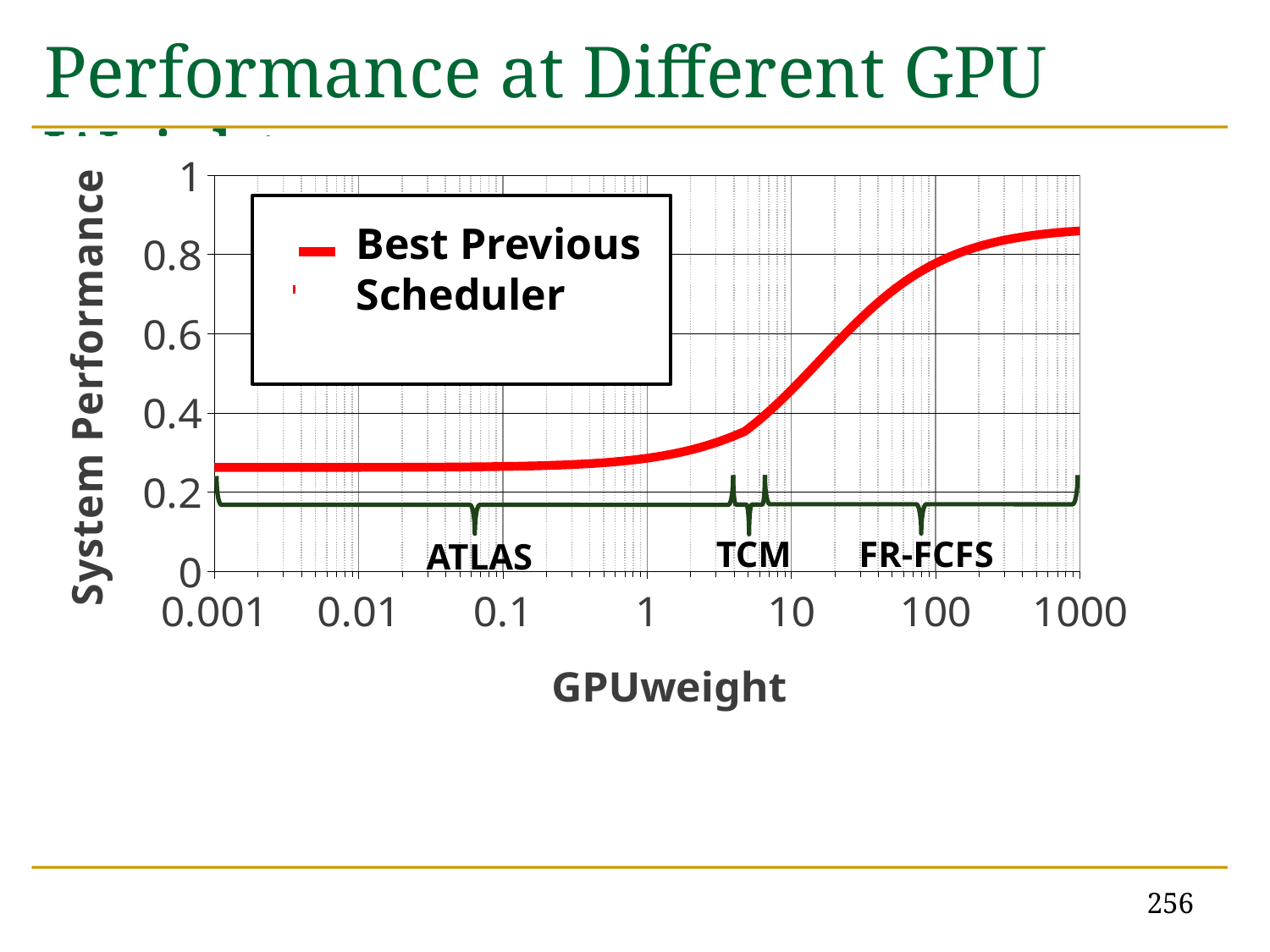
Is the System Performance of the Best Previous Scheduler at GPUweight 1000 greater or less than 0.8? greater Does the System Performance of the Best Previous Scheduler rise or fall as GPUweight increases? rise How many series does the legend list? 1 How many labelled tick values are shown on the x axis? 7 What kind of chart is shown on the slide? line chart Which GPUweight value, 0.01 or 1000, gives the higher System Performance for the Best Previous Scheduler? 1000 What is the label of the x axis? GPUweight What is the name of the series shown in the legend? Best Previous Scheduler Is the System Performance of the Best Previous Scheduler at GPUweight 0.001 greater or less than 0.4? less Is the System Performance of the Best Previous Scheduler at GPUweight 1 greater or less than 0.4? less